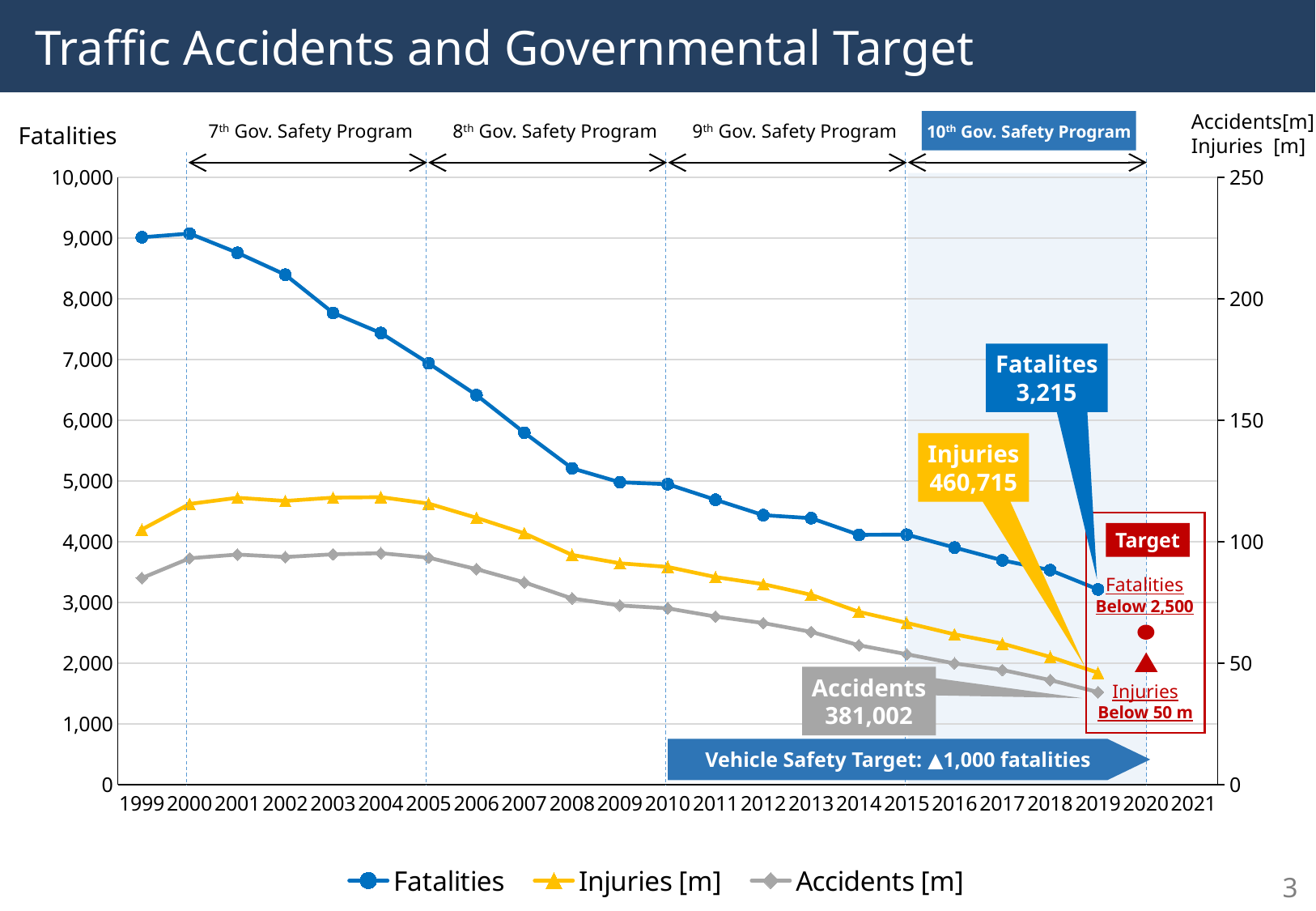
What is the target for injuries shown in the Target box? Below 50 m What value is shown in the Injuries callout? 460,715 Do fatalities rise or fall from 1999 to 2019? fall What value is shown in the Accidents callout? 381,002 Is the value for Fatalities in 2015 greater or less than 5,000? less Is the value for Fatalities in 1999 greater or less than 8,000? greater What is the number of fatalities shown in the callout for 2019? 3,215 By how much do the 2019 fatalities (3,215) exceed the target of 2,500? 715 Which is larger, fatalities in 2005 or fatalities in 2010? 2005 Which year has the lowest number of fatalities? 2019 What kind of chart is shown on the slide? line chart How many series does the legend list? 3